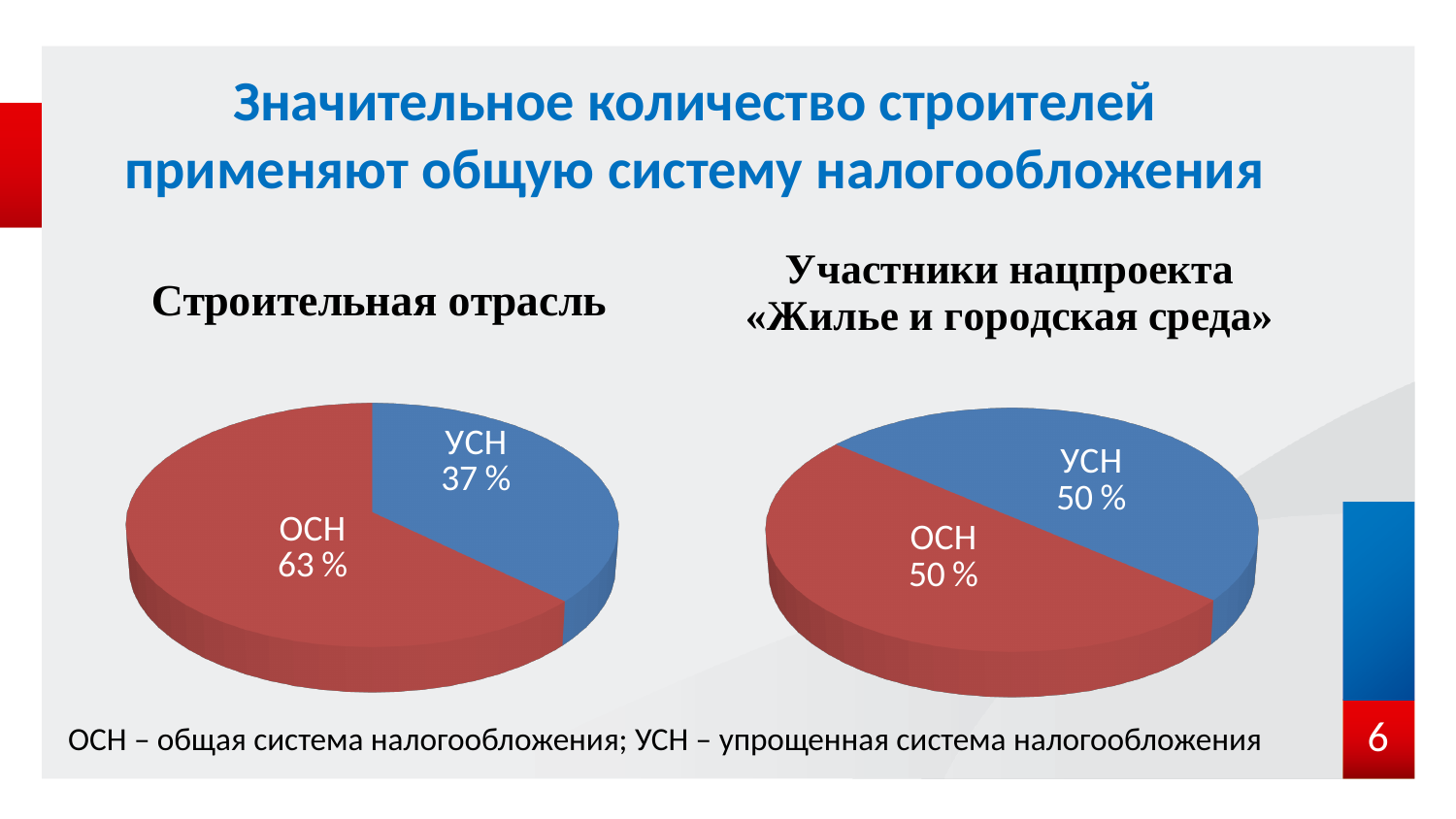
In the "Участники нацпроекта «Жилье и городская среда»" chart, what share is labelled for УСН? 50 % How many pie charts are shown on the slide? 2 In the "Строительная отрасль" chart, what share is labelled for ОСН? 63 % How many slices does the "Участники нацпроекта «Жилье и городская среда»" chart have? 2 In the "Строительная отрасль" chart, which slice is the largest? ОСН In the "Строительная отрасль" chart, which is larger, ОСН or УСН? ОСН What kind of chart is the left chart on the slide? Pie chart In the "Участники нацпроекта «Жилье и городская среда»" chart, what share is labelled for ОСН? 50 % In the "Строительная отрасль" chart, what share is labelled for УСН? 37 % In the "Строительная отрасль" chart, what colour is the ОСН slice? Red In the "Строительная отрасль" chart, which slice is the smallest? УСН In the "Строительная отрасль" chart, what is the difference in percentage points between the ОСН and УСН slices? 26